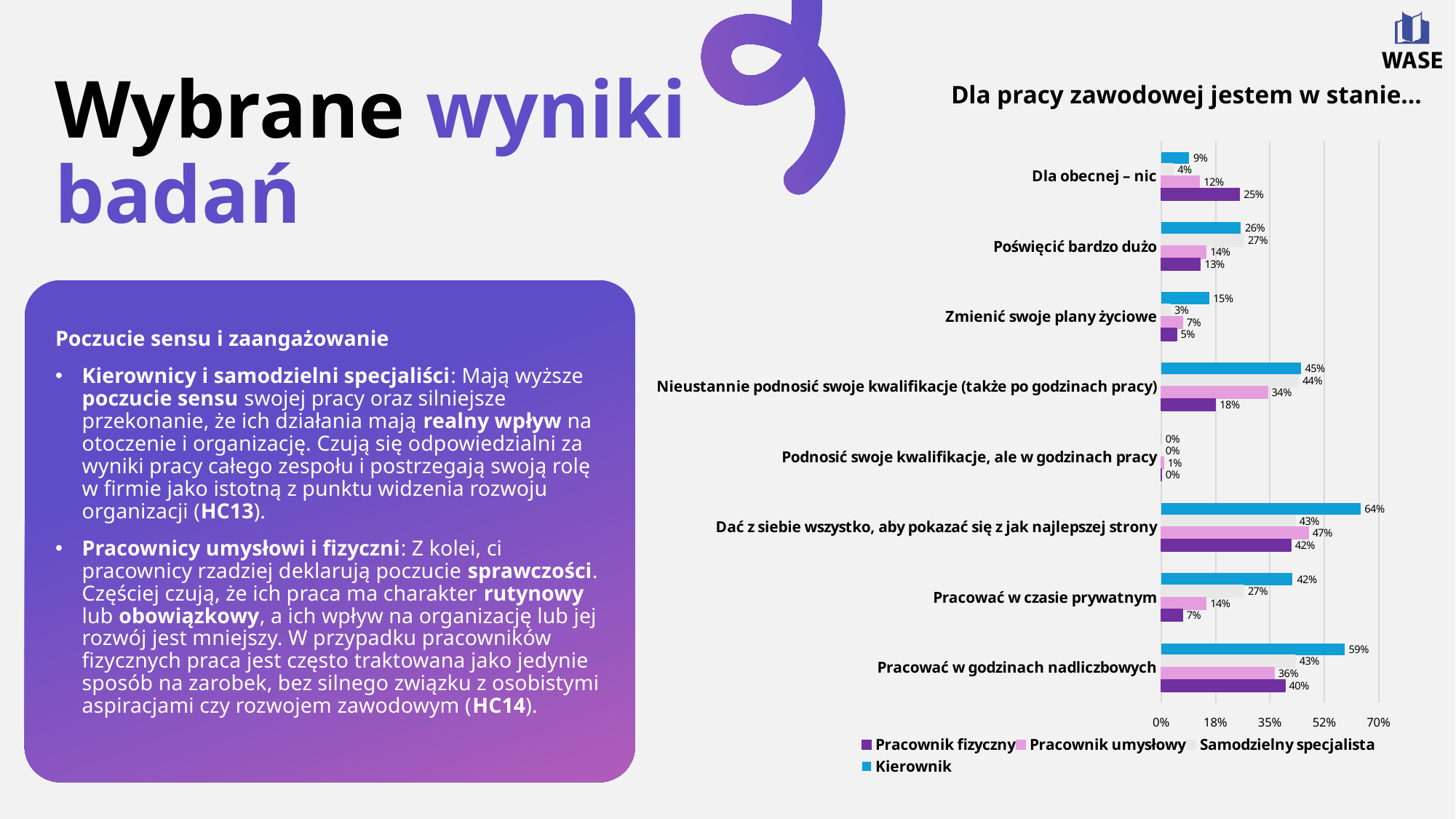
How many series does the legend list? 4 What is the value for Samodzielny specjalista in the category "Nieustannie podnosić swoje kwalifikacje (także po godzinach pracy)"? 44% Which category has the highest value for Kierownik? Dać z siebie wszystko, aby pokazać się z jak najlepszej strony In the category "Pracować w godzinach nadliczbowych", which is larger: the value for Pracownik fizyczny or for Pracownik umysłowy? Pracownik fizyczny What is the difference between the Kierownik and Pracownik fizyczny values for "Pracować w czasie prywatnym"? 35% Which category has the lowest value for Pracownik umysłowy? Podnosić swoje kwalifikacje, ale w godzinach pracy What kind of chart is shown on the slide? Bar chart What is the value for Pracownik fizyczny in the category "Dla obecnej – nic"? 25% What is the value for Kierownik in the category "Dać z siebie wszystko, aby pokazać się z jak najlepszej strony"? 64% What is the title of the chart? Dla pracy zawodowej jestem w stanie… How many categories are shown on the chart? 8 What is the value for Pracownik umysłowy in the category "Pracować w godzinach nadliczbowych"? 36%